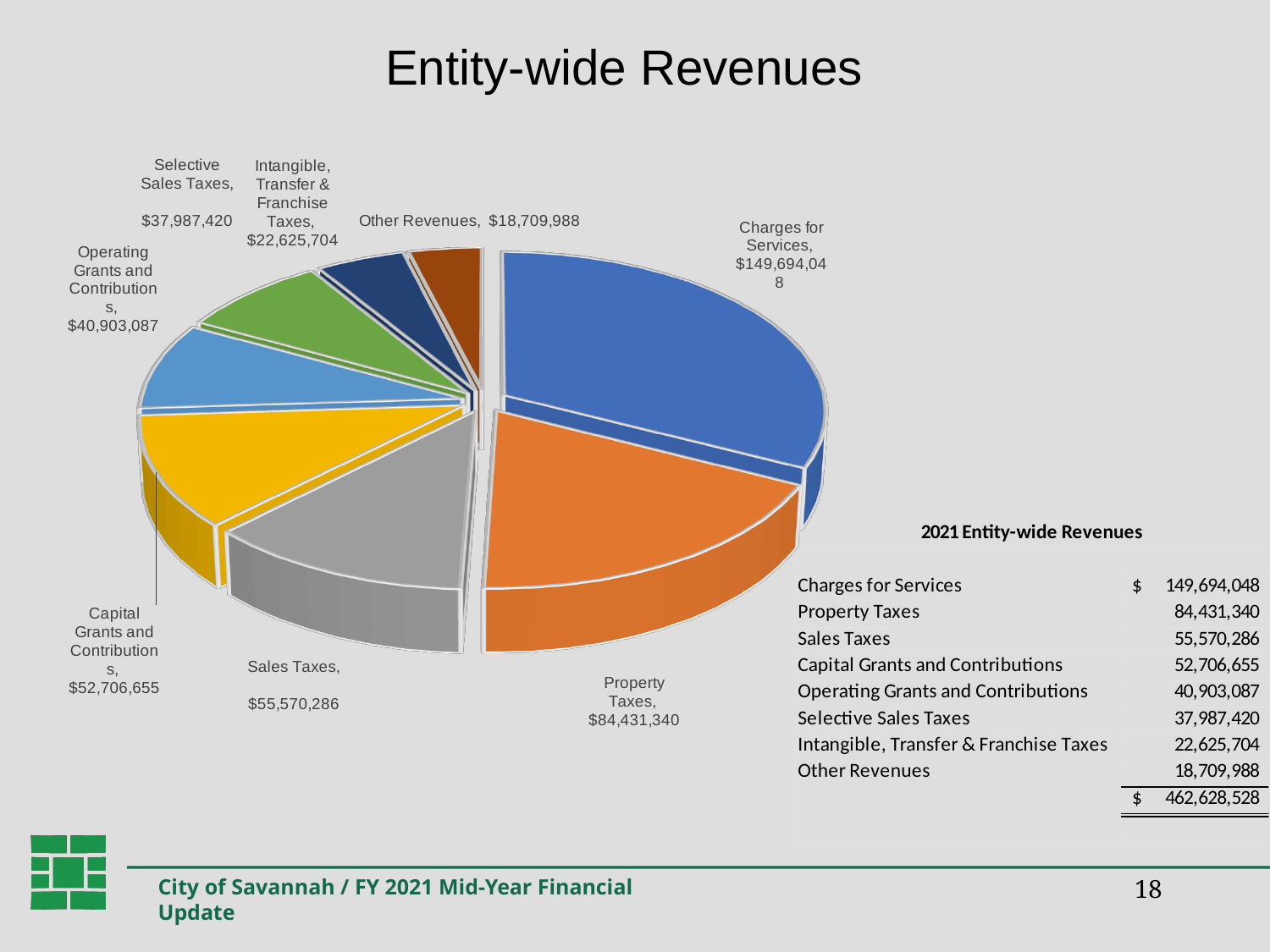
What type of chart is shown on the slide? Pie chart What is the value for Operating Grants and Contributions in the pie chart? $40,903,087 What is the difference between Property Taxes and Sales Taxes in the pie chart? $28,861,054 What is the value for Charges for Services in the pie chart? $149,694,048 What is the title of the chart on the slide? Entity-wide Revenues What is the value for Intangible, Transfer & Franchise Taxes in the pie chart? $22,625,704 What is the difference between Capital Grants and Contributions and Operating Grants and Contributions? $11,803,568 Which category has the smallest slice in the pie chart? Other Revenues Which category has the largest slice in the pie chart? Charges for Services Which is larger, Sales Taxes or Capital Grants and Contributions? Sales Taxes What is the value for Property Taxes in the pie chart? $84,431,340 How many slices does the pie chart have? 8